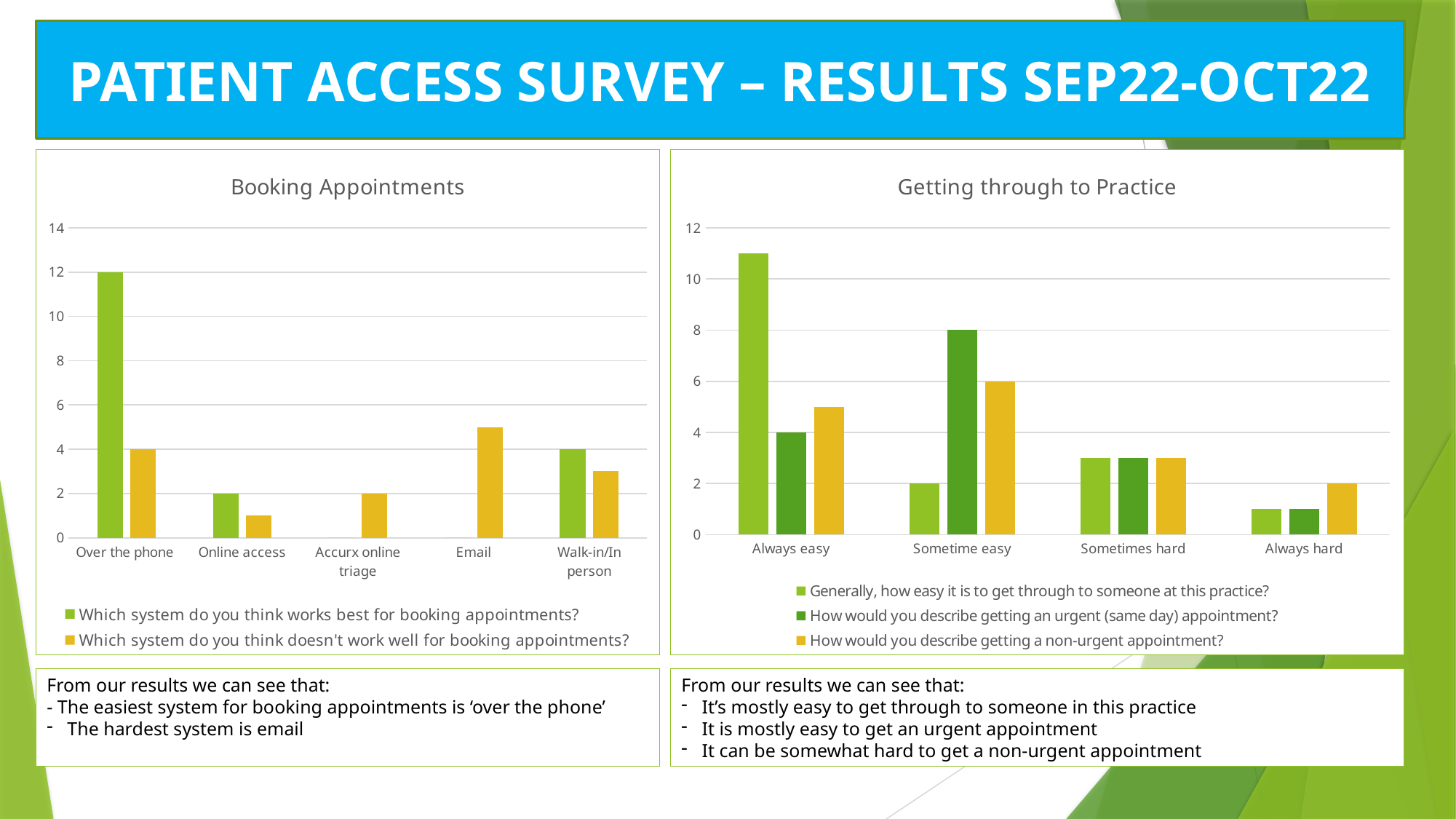
How many series does the legend of the Getting through to Practice chart list? 3 In the Getting through to Practice chart, what is the value for Sometime easy in the series 'How would you describe getting a non-urgent appointment?' 6 In the Getting through to Practice chart, is the value for Always easy in the series 'Generally, how easy it is to get through to someone at this practice?' greater or less than 10? greater In the Booking Appointments chart, what is the value for Over the phone in the series 'Which system do you think doesn't work well for booking appointments?' 4 In the Booking Appointments chart, is the value for Email in the 'doesn't work well' series greater or less than 4? greater In the Booking Appointments chart, what is the value for Over the phone in the series 'Which system do you think works best for booking appointments?' 12 In the Getting through to Practice chart, what is the value for Sometime easy in the series 'How would you describe getting an urgent (same day) appointment?' 8 What type of chart is the Getting through to Practice chart? bar chart In the Booking Appointments chart, what is the difference between the two series' values for Over the phone? 8 In the Booking Appointments chart, which category has the highest value for 'Which system do you think works best for booking appointments?' Over the phone How many categories are shown on the x axis of the Booking Appointments chart? 5 In the Getting through to Practice chart, which category has the lowest value for 'How would you describe getting an urgent (same day) appointment?' Always hard